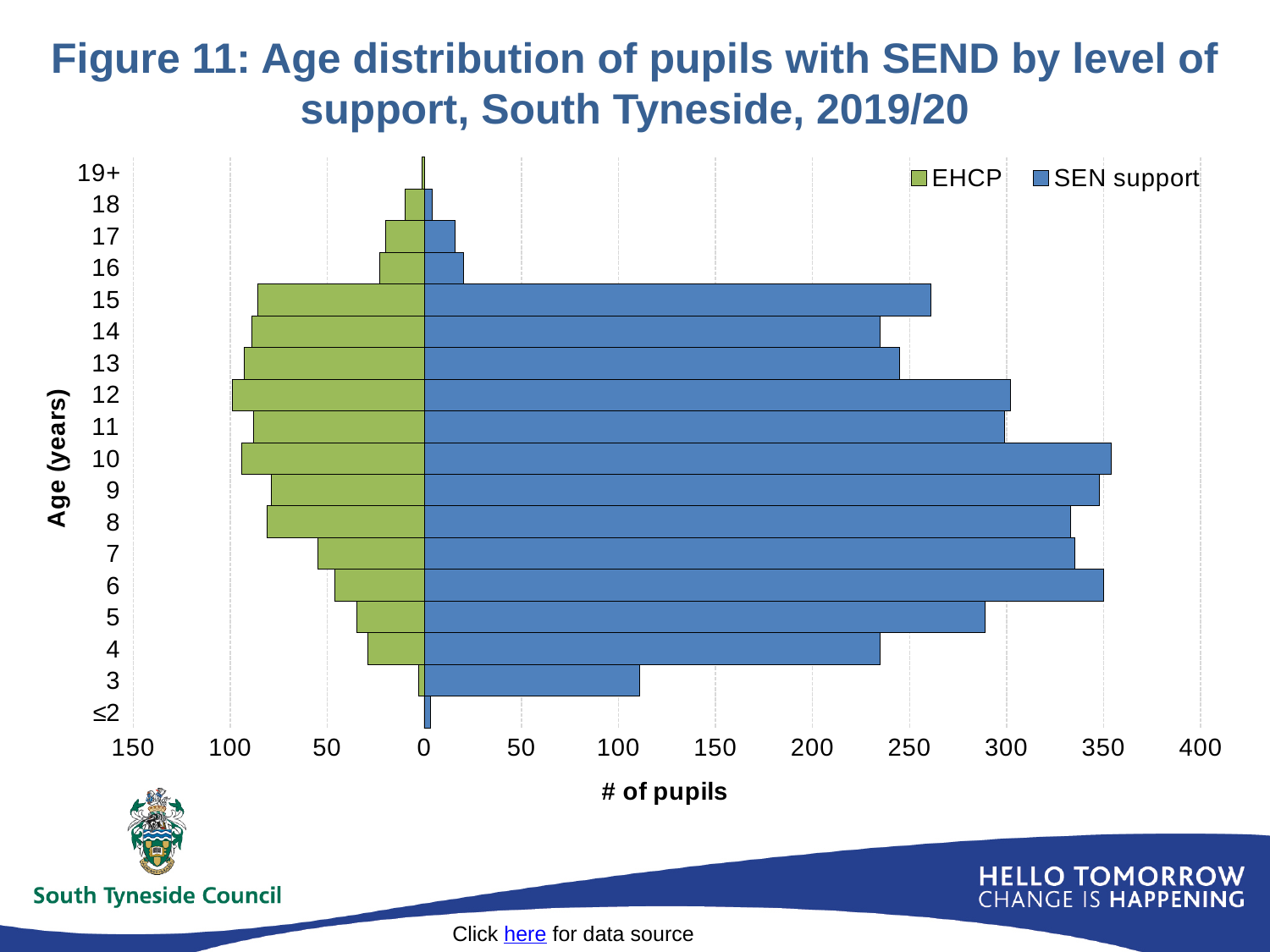
What is the label of the x axis? # of pupils Do the EHCP values rise or fall from age 12 to age 18? fall Is the SEN support value for age 16 greater or less than 50? less Which has more SEN support pupils, age 14 or age 15? age 15 How many series does the legend list? 2 Which has more EHCP pupils, age 8 or age 17? age 8 Is the SEN support value for age 15 greater or less than 250? greater Is the SEN support value for age 3 greater or less than 100? greater What kind of chart is shown on the slide? bar chart How many age groups are shown on the y axis? 18